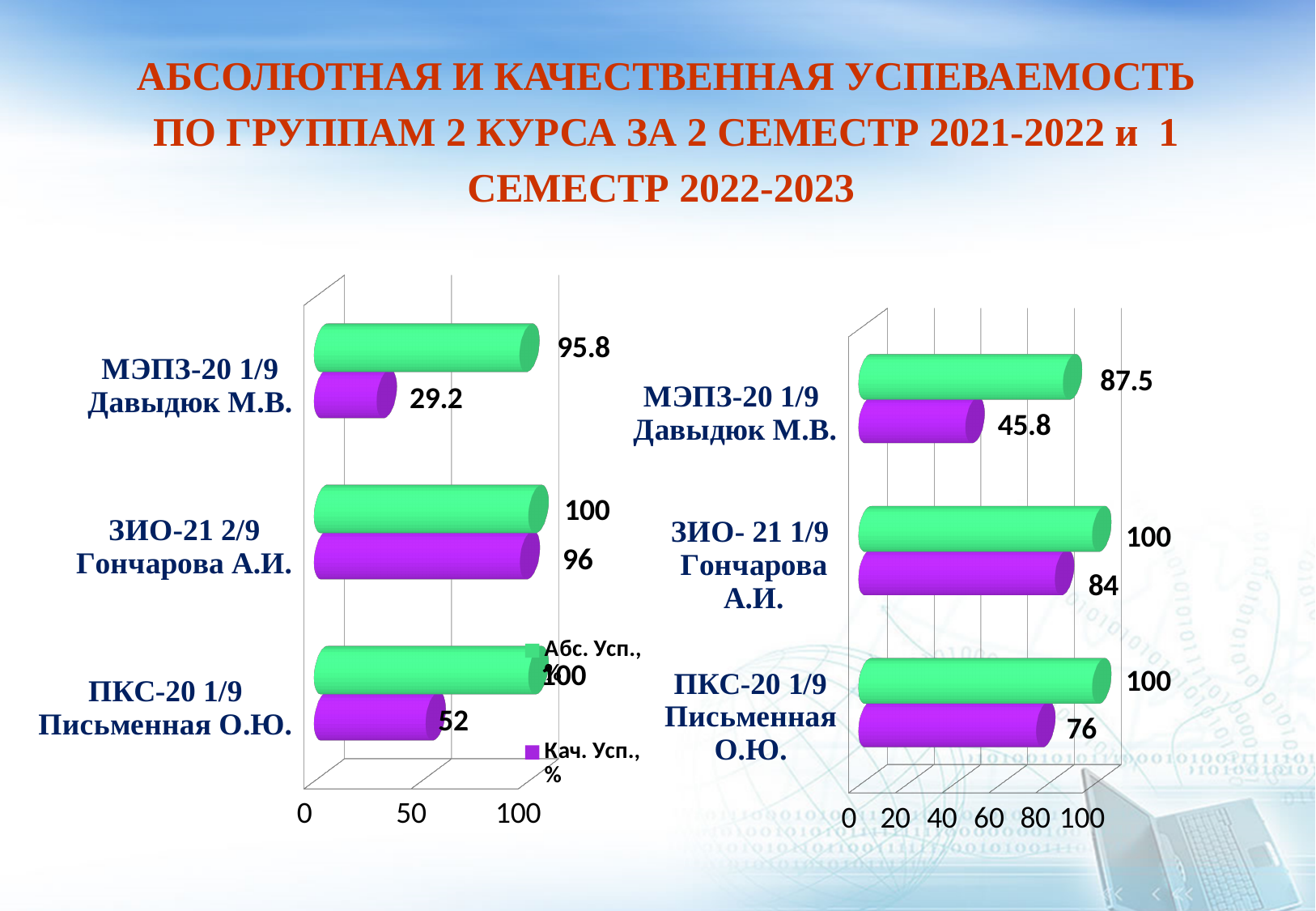
In the left chart, what is the difference between Абс. Усп., % and Кач. Усп., % for ЗИО-21 2/9 Гончарова А.И.? 4 In the left chart, how many series does the legend list? 2 What type of chart is the left chart? bar chart In the right chart, what is the value of the purple bar for ЗИО- 21 1/9 Гончарова А.И.? 84 In the left chart, which group has the lowest Кач. Усп., % value? МЭПЗ-20 1/9 Давыдюк М.В. In the right chart, what is the difference between the green and purple bar values for ПКС-20 1/9 Письменная О.Ю.? 24 In the right chart, what is the value of the green bar for МЭПЗ-20 1/9 Давыдюк М.В.? 87.5 In the left chart, what is the value of Кач. Усп., % for ПКС-20 1/9 Письменная О.Ю.? 52 In the right chart, which group has the highest purple bar value? ЗИО- 21 1/9 Гончарова А.И. In the left chart, what is the value of Абс. Усп., % for МЭПЗ-20 1/9 Давыдюк М.В.? 95.8 In the right chart, is the purple bar value for МЭПЗ-20 1/9 Давыдюк М.В. larger or smaller than the purple bar value for ПКС-20 1/9 Письменная О.Ю.? smaller How many groups are shown in the right chart? 3